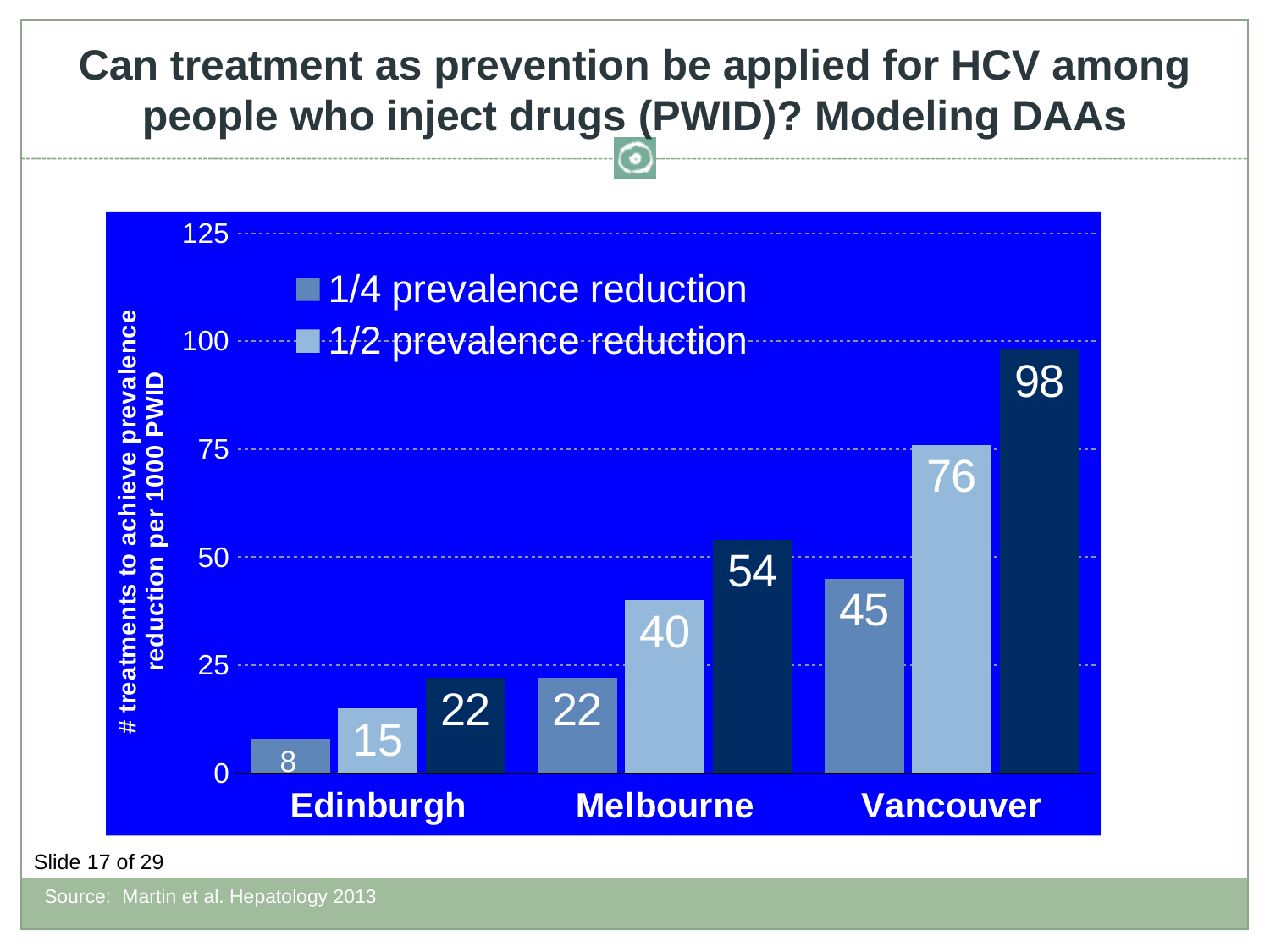
What is the value for Melbourne in the 1/2 prevalence reduction series? 40 Which is larger: the 1/4 prevalence reduction value for Vancouver or the 1/2 prevalence reduction value for Melbourne? 1/4 prevalence reduction value for Vancouver What kind of chart is shown on the slide? bar chart How many series does the legend list? 2 Is the 1/2 prevalence reduction value for Vancouver greater or less than 50? greater How many cities are shown on the x axis? 3 What is the difference between Vancouver and Melbourne in the 1/2 prevalence reduction series? 36 What is the value for Edinburgh in the 1/4 prevalence reduction series? 8 Which city has the lowest value in the 1/4 prevalence reduction series? Edinburgh What is the label of the y axis? # treatments to achieve prevalence reduction per 1000 PWID Which city has the highest value in the 1/2 prevalence reduction series? Vancouver What is the value for Vancouver in the 1/4 prevalence reduction series? 45